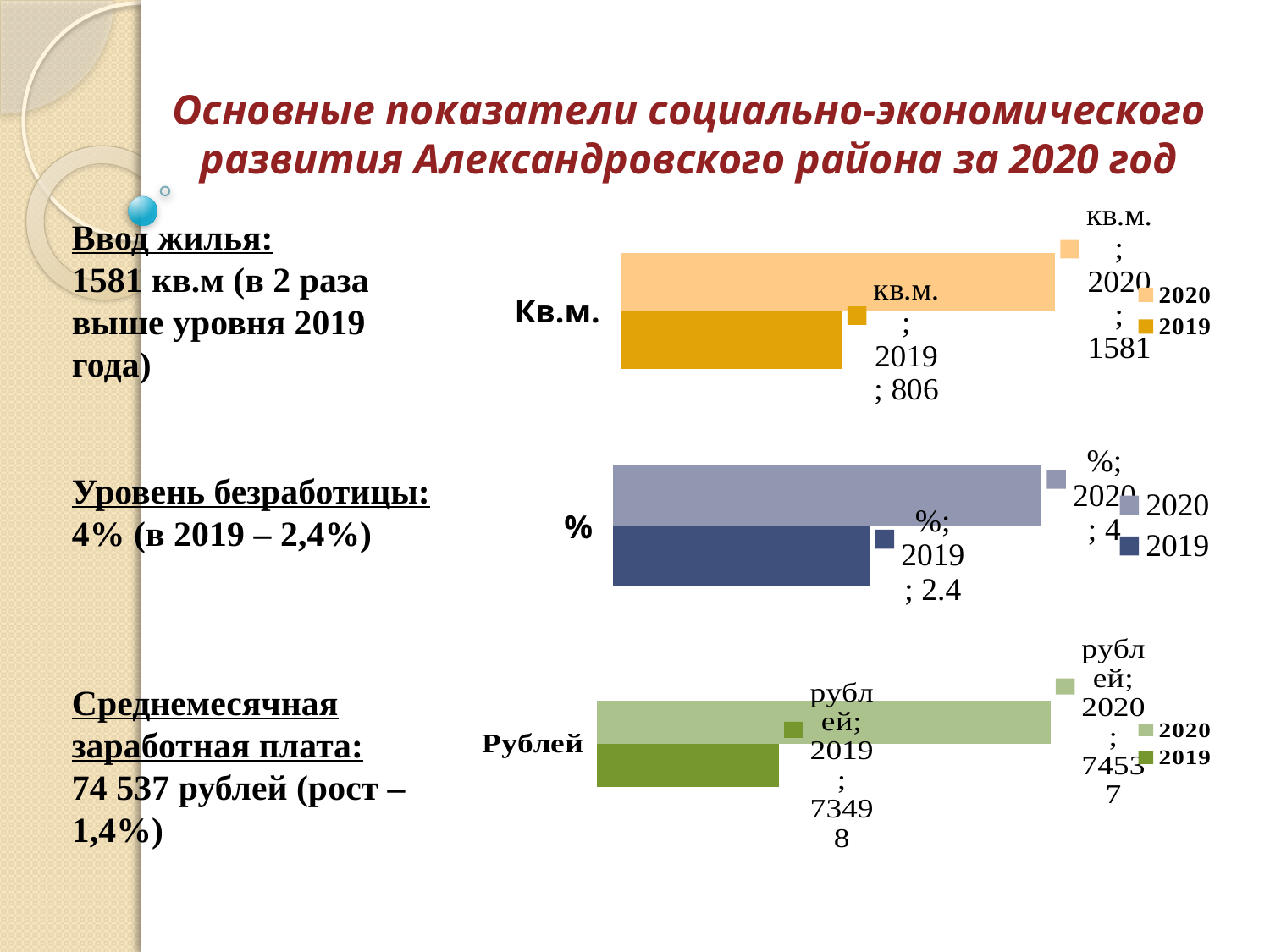
How many charts are shown on the slide? 3 How many series does the legend of the top chart (Кв.м.) list? 2 What type of chart is the bottom chart (Рублей)? Bar chart In the top chart (Кв.м.), what is the value for 2020? 1581 In the bottom chart (Рублей), what is the value for 2020? 74537 In the middle chart (%), what is the value for 2019? 2.4 In the middle chart (%), which year has the larger value, 2020 or 2019? 2020 In the bottom chart (Рублей), what is the difference between the 2020 and 2019 values? 1039 In the top chart (Кв.м.), what is the difference between the 2020 and 2019 values? 775 In the top chart (Кв.м.), what is the value for 2019? 806 In the bottom chart (Рублей), what is the value for 2019? 73498 In the middle chart (%), what is the value for 2020? 4